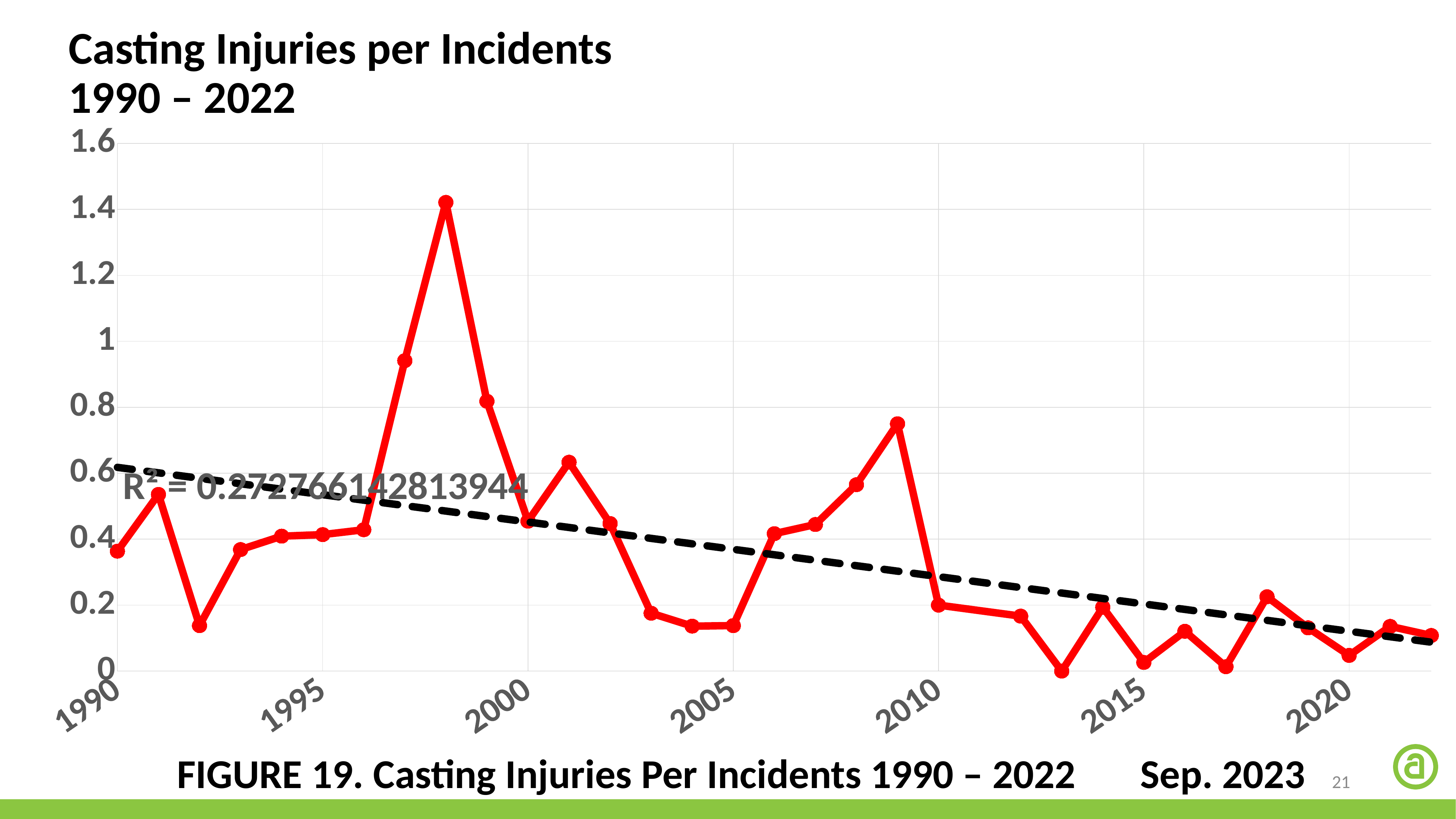
Is the value for 1998 greater or less than 1.2? greater Which year has the highest casting injuries per incidents value? 1998 Is the value for 1992 greater or less than 0.2? less Which year has the larger value, 1998 or 2009? 1998 Which year has the larger value, 1991 or 1992? 1991 What is the title of the chart? Casting Injuries per Incidents 1990 – 2022 Is the value for 1997 greater or less than 0.8? greater What kind of chart is shown on the slide? line chart How many yearly data points are plotted on the chart? 32 According to the dashed trend line, do the values generally rise or fall from 1990 to 2022? fall